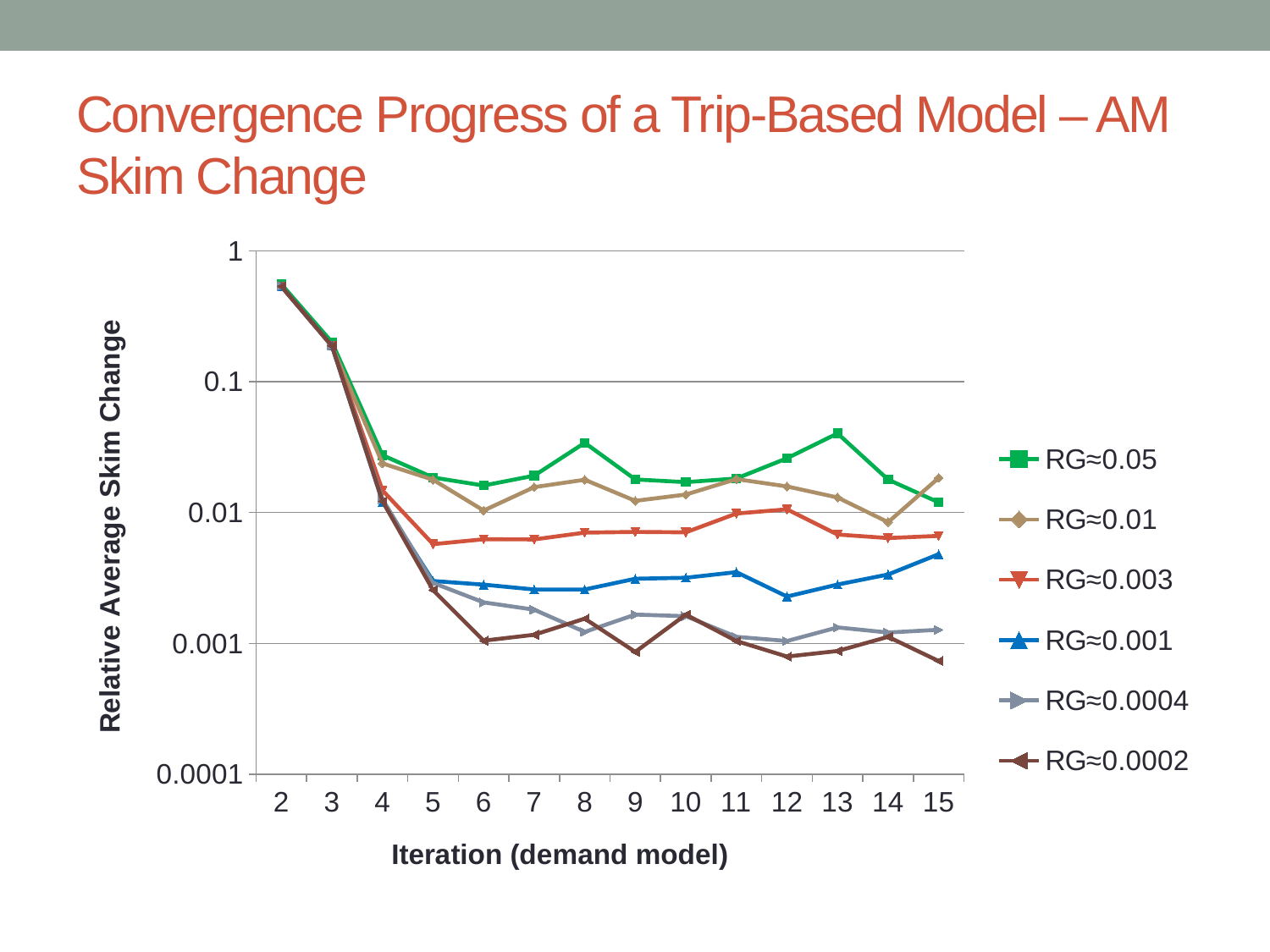
What is the title of the chart? Convergence Progress of a Trip-Based Model – AM Skim Change Does the RG≈0.003 series rise or fall overall from iteration 2 to iteration 15? fall Is the value for RG≈0.0002 at iteration 15 greater or less than 0.001? less How many iterations are plotted along the x axis? 14 How many series does the legend list? 6 Is the value for RG≈0.05 at iteration 13 greater or less than 0.01? greater Which series has the lowest value at iteration 15? RG≈0.0002 At iteration 13, which series has the higher value: RG≈0.05 or RG≈0.0002? RG≈0.05 What kind of chart is shown on the slide? line chart Is the value for RG≈0.05 at iteration 2 greater or less than 0.1? greater What is the label of the y axis? Relative Average Skim Change